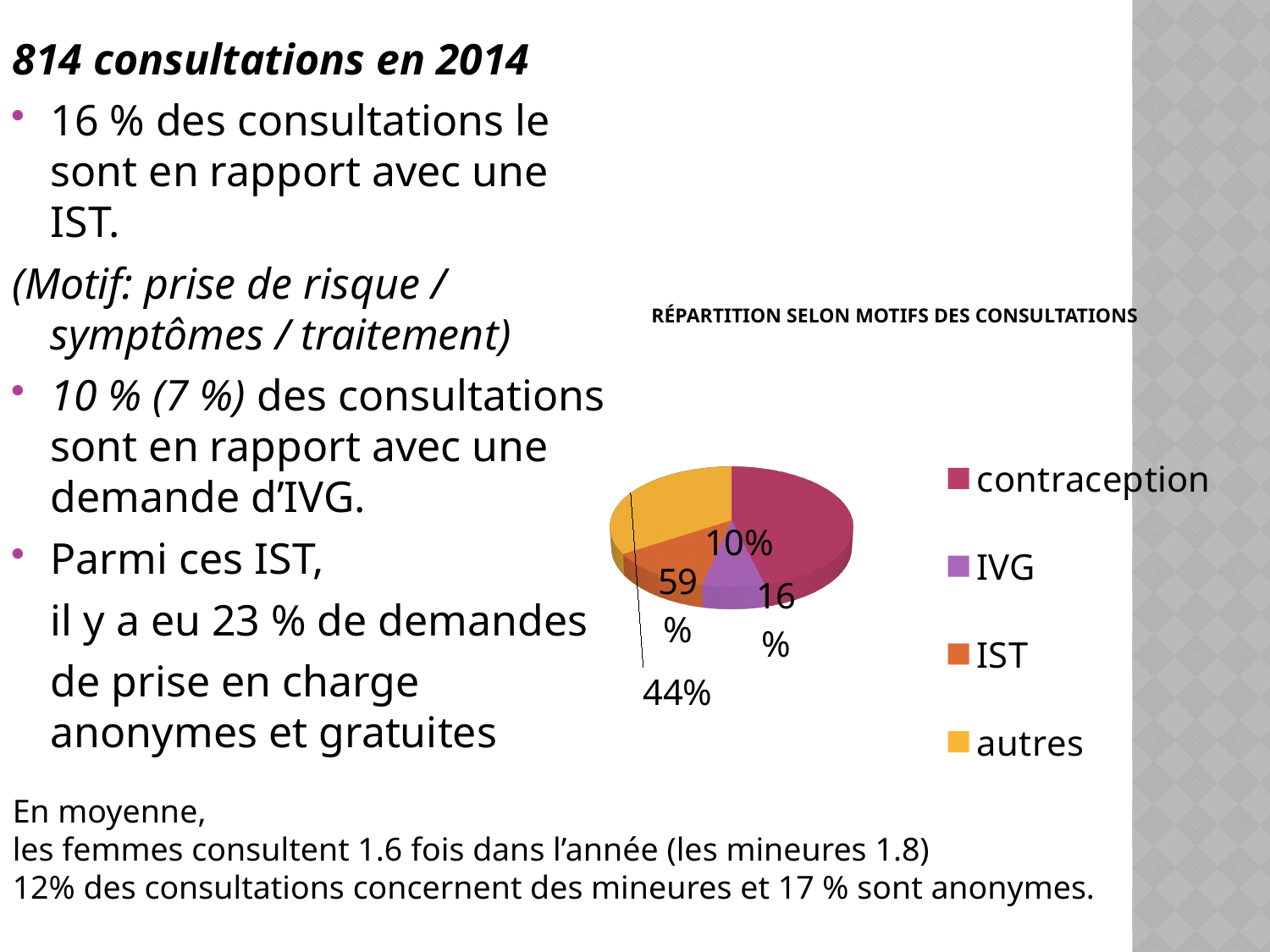
Which slice is larger, autres or IVG? autres Which slice is larger, IST or IVG? IST What share of the pie does IVG represent? 10% Which category has the largest slice of the pie? contraception Which colour represents IST in the pie chart's legend? orange What kind of chart is shown on the slide? pie chart Which category has the smallest slice of the pie? IVG Is the share for IVG greater or less than 50%? less What share of the pie does IST represent? 16% What is the title of the pie chart? RÉPARTITION SELON MOTIFS DES CONSULTATIONS Which slice is larger, contraception or IVG? contraception How many categories does the pie chart's legend list? 4